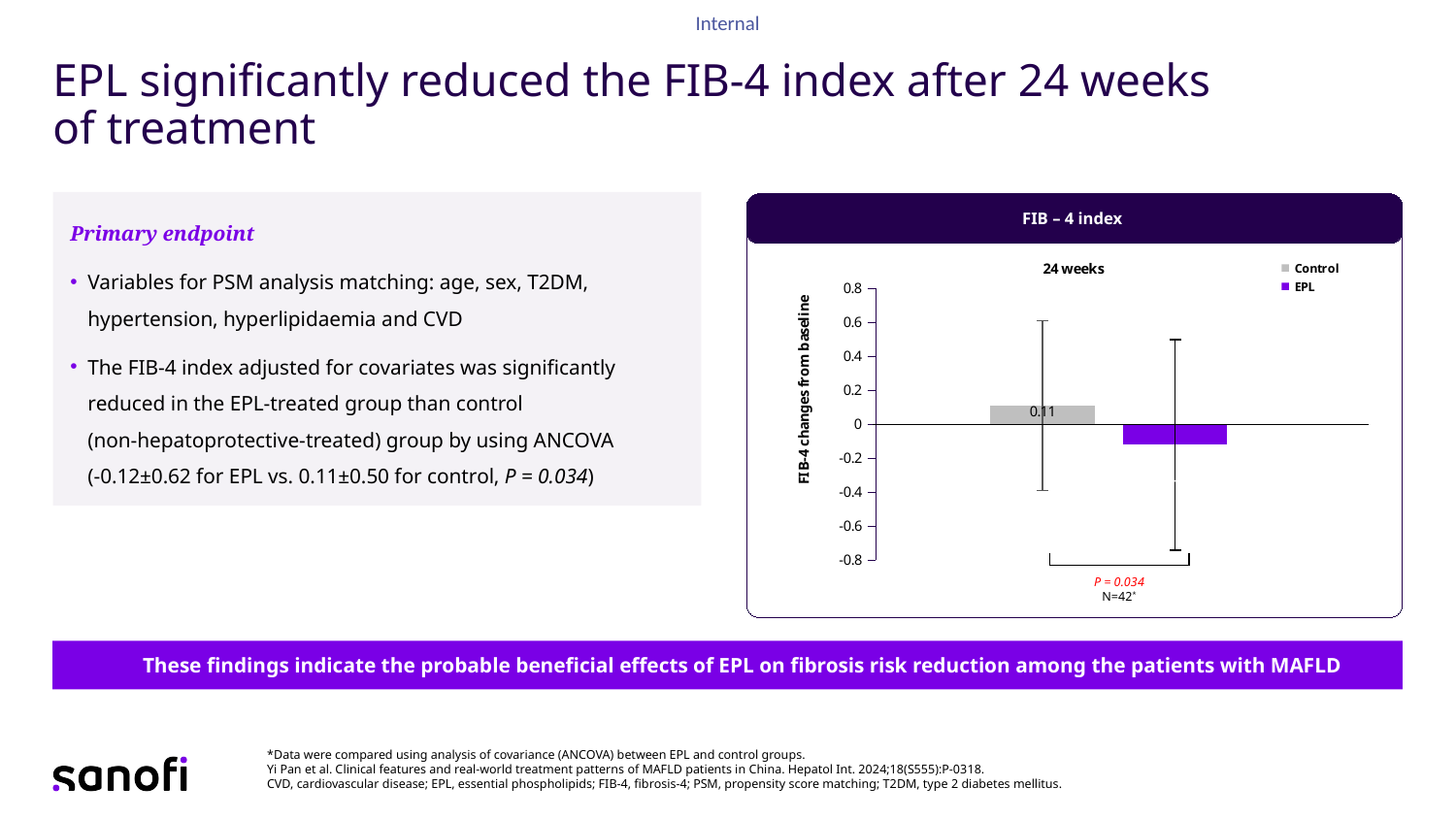
What is the maximum value shown on the y axis of the FIB-4 index chart? 0.8 Is the value of the Control bar in the FIB-4 index chart greater or less than 0.2? less Which series shows the lowest FIB-4 change from baseline in the chart? EPL Which series has the higher bar in the FIB-4 index chart, Control or EPL? Control How many series does the legend of the FIB-4 index chart list? 2 What is the y-axis label of the FIB-4 index chart? FIB-4 changes from baseline How many time points are shown on the x axis of the FIB-4 index chart? 1 What is the value of the Control bar in the FIB-4 index chart? 0.11 What type of chart is used to show the FIB-4 index changes? Bar chart Is the value of the EPL bar in the FIB-4 index chart greater or less than 0? less Which series shows the highest FIB-4 change from baseline in the chart? Control What is the title of the chart on the slide? FIB – 4 index